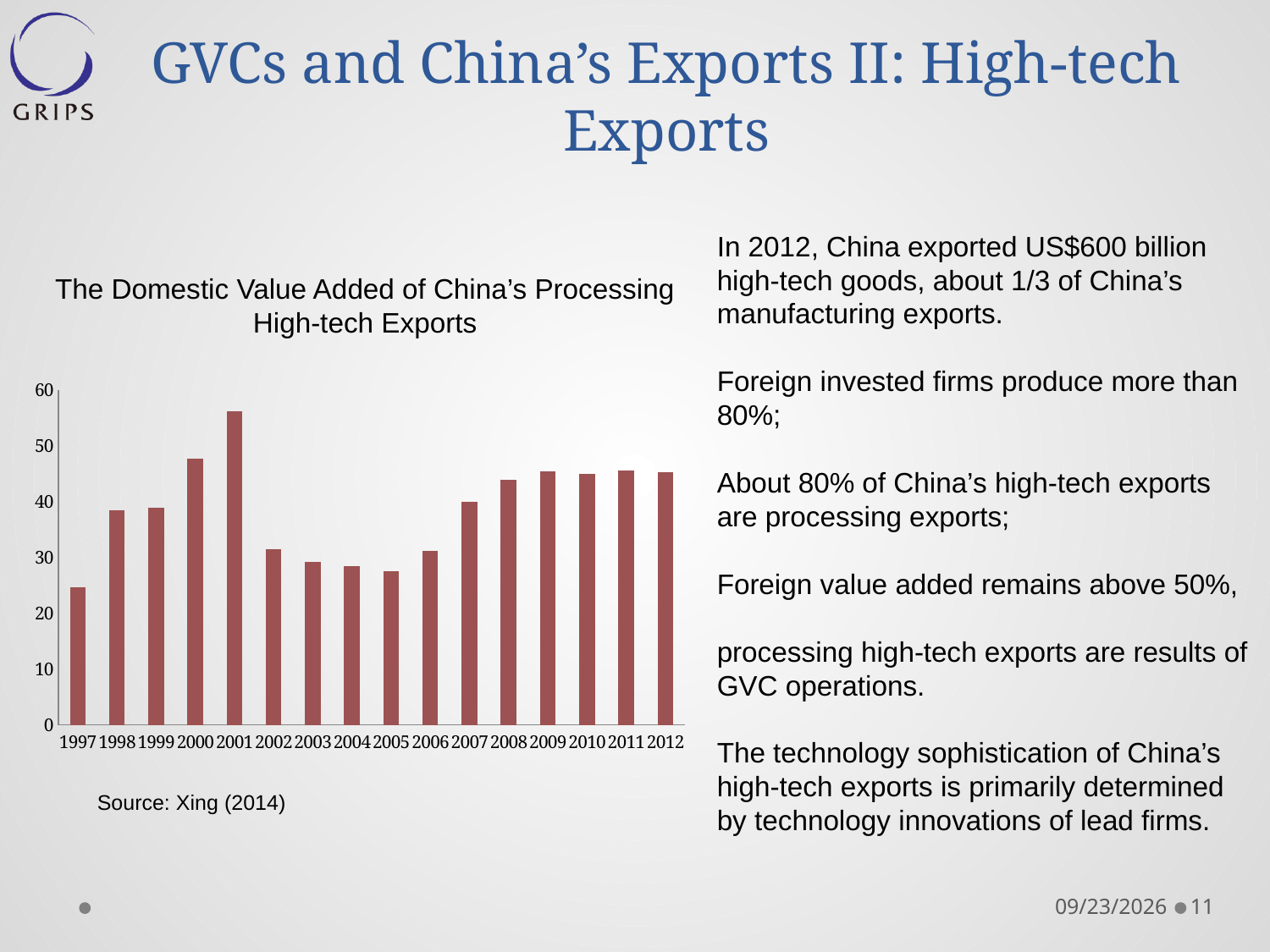
What kind of chart is shown on the slide? bar chart Is the value for 2005 greater or less than 30? less Which year has the highest domestic value added in the chart? 2001 Which year has the larger value, 1997 or 1998? 1998 What is the title of the chart? The Domestic Value Added of China's Processing High-tech Exports Is the value for 2001 greater or less than 50? greater Is the value for 2000 greater or less than 40? greater Which year has the lowest domestic value added in the chart? 1997 Do the values rise or fall from 2001 to 2005? fall How many years are shown on the x axis of the chart? 16 Which year has the larger value, 2000 or 2002? 2000